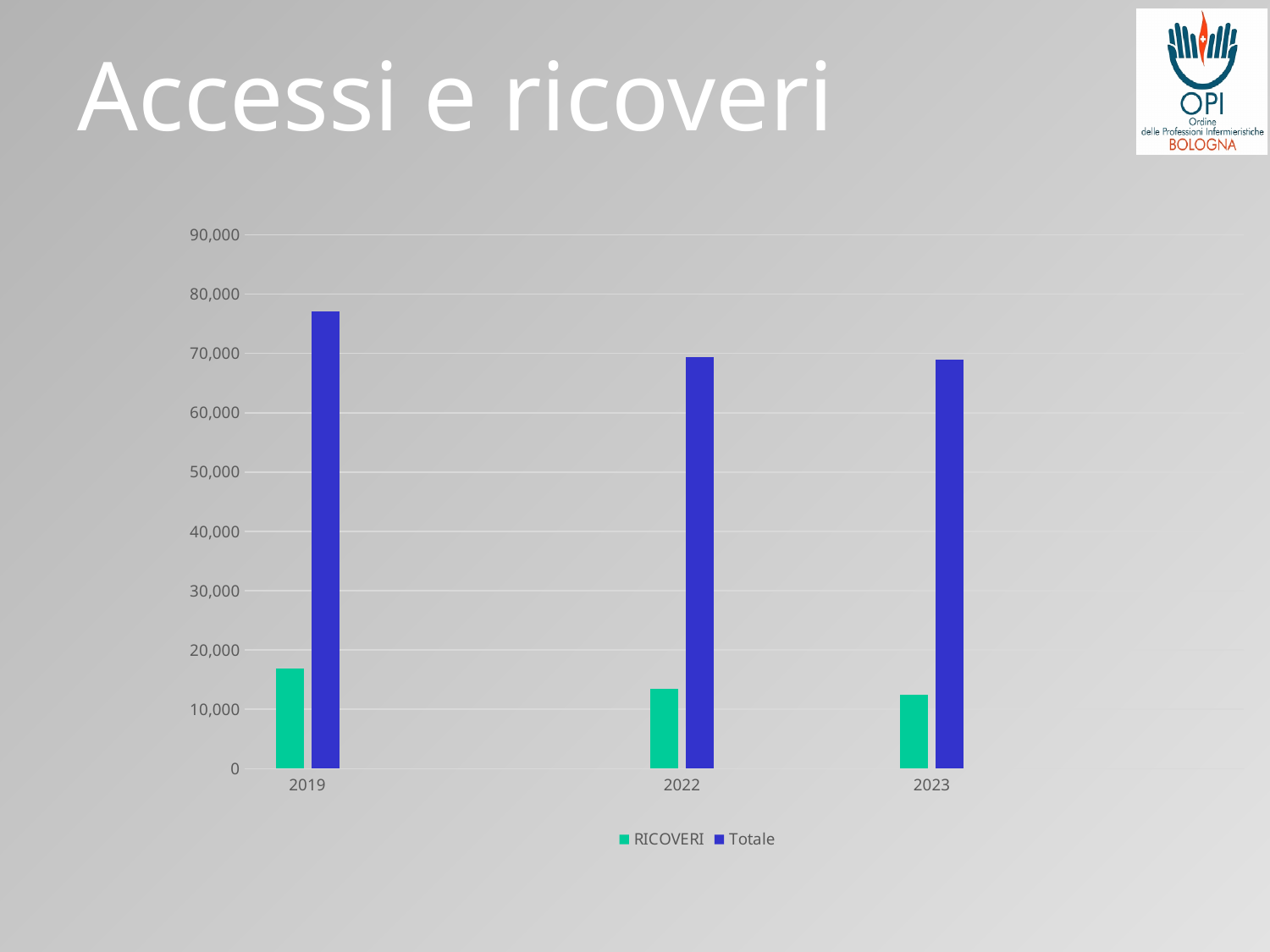
Is the Totale value for 2019 greater or less than 70,000? greater How many years are shown on the x axis? 3 Is the Totale value for 2022 greater or less than 60,000? greater Which year has the highest RICOVERI value? 2019 Is the RICOVERI value for 2023 greater or less than 10,000? greater How many series does the legend list? 2 Which year has the highest Totale value? 2019 Does the Totale value rise or fall from 2019 to 2023? fall What kind of chart is shown on the slide? bar chart Which year has the lowest RICOVERI value? 2023 Is the RICOVERI value for 2019 larger or smaller than the RICOVERI value for 2022? larger